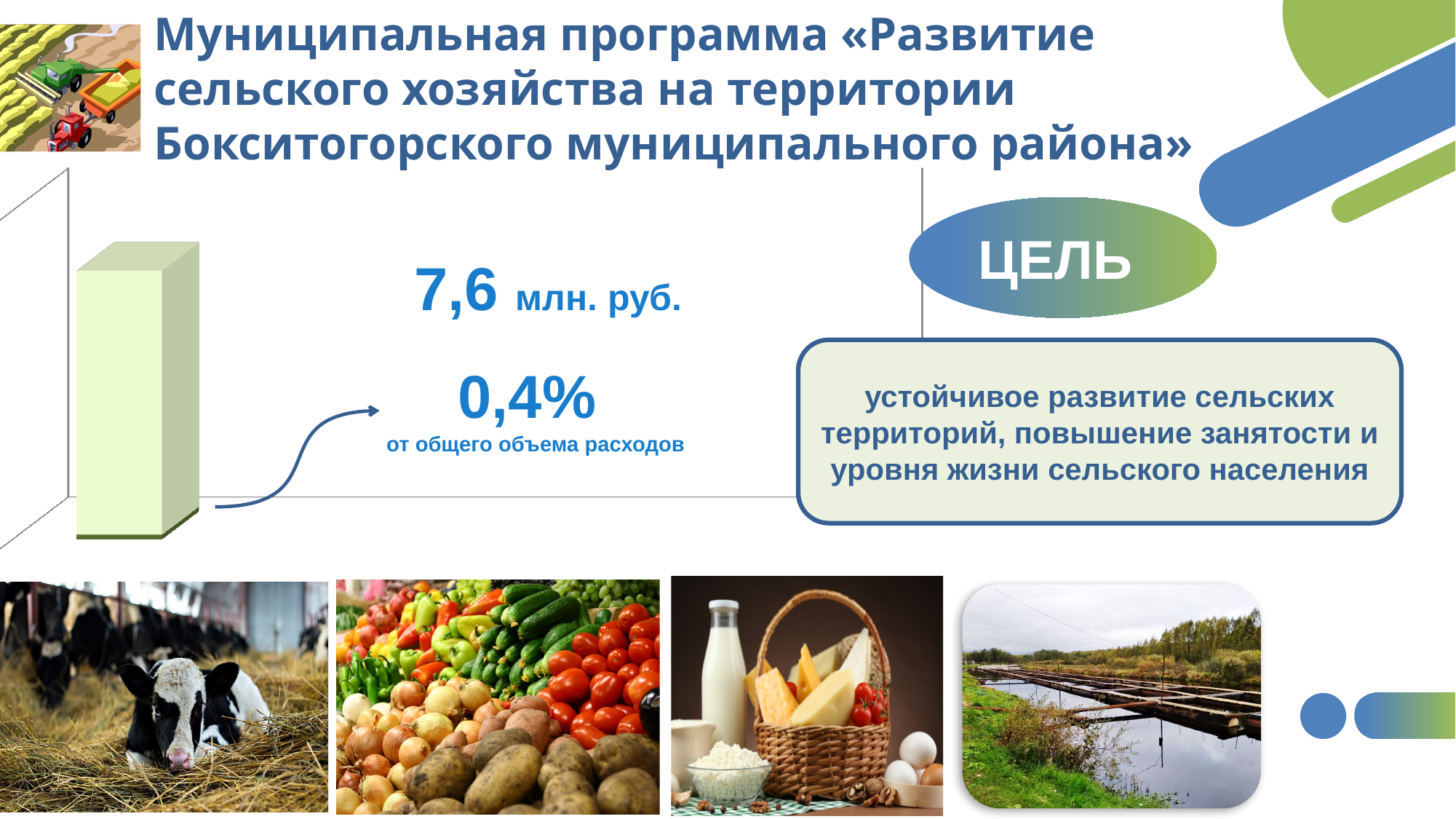
Is the value shown for the bar on the slide greater or less than 1% of total expenditure? less How many bars does the chart on the slide contain? 1 What colour is the bar in the chart on the slide? light green What amount in million rubles is shown next to the bar on the slide? 7,6 млн. руб. What kind of chart is shown on the left of the slide? bar chart What text appears under the 0,4% label next to the bar? от общего объема расходов What percentage of total expenditure does the bar on the slide represent, according to the label the arrow points to? 0,4%